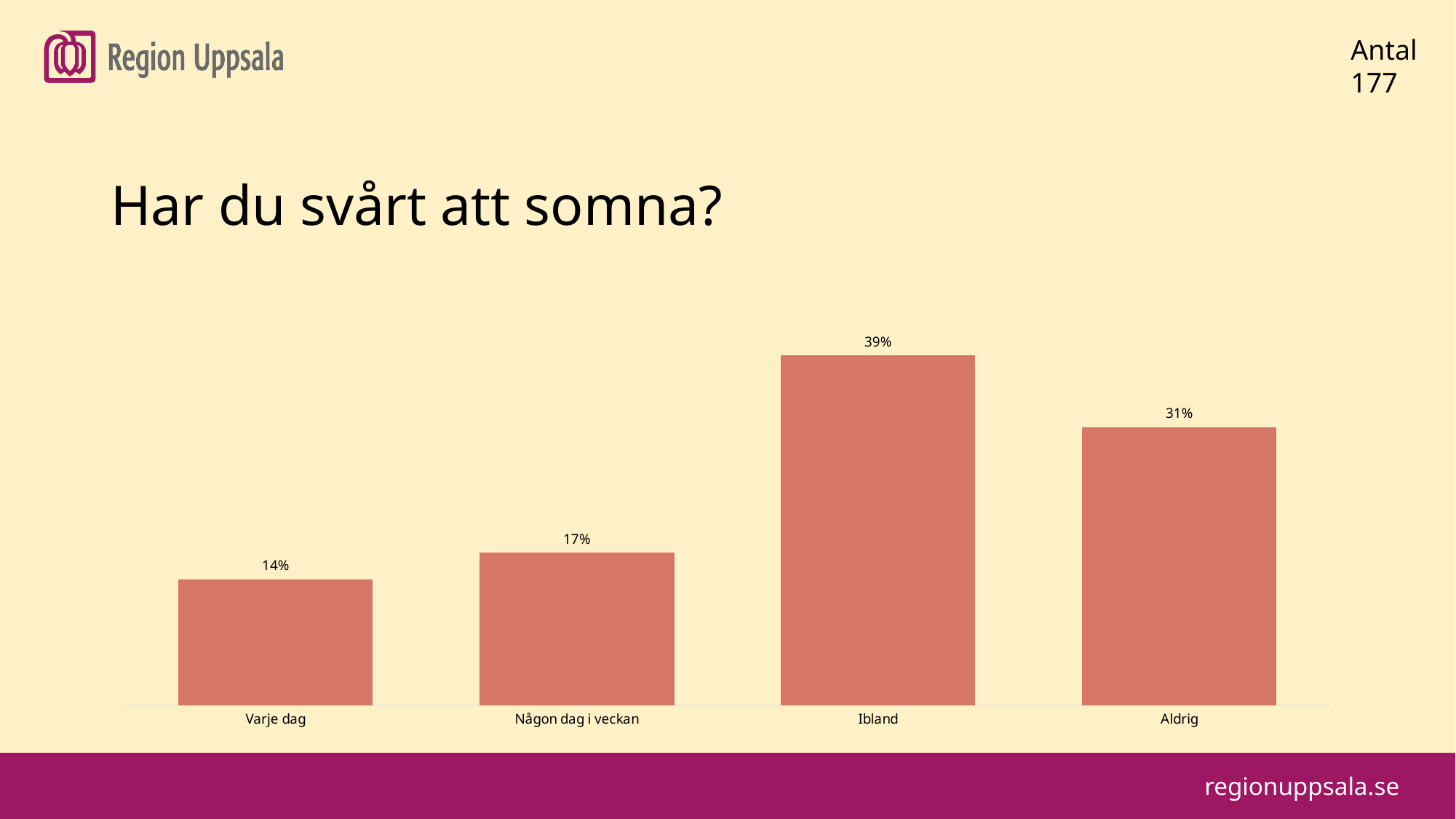
What kind of chart is shown on the slide? Bar chart What is the value for "Aldrig"? 31% Which is larger, the value for "Aldrig" or the value for "Någon dag i veckan"? Aldrig What is the value for "Varje dag"? 14% How many categories are shown in the chart? 4 Which category has the lowest value? Varje dag What is the title of the chart on the slide? Har du svårt att somna? What is the difference between the values for "Någon dag i veckan" and "Varje dag"? 3% What is the value for "Någon dag i veckan"? 17% Which category has the highest value? Ibland What is the difference between the values for "Ibland" and "Aldrig"? 8% What is the value for "Ibland"? 39%